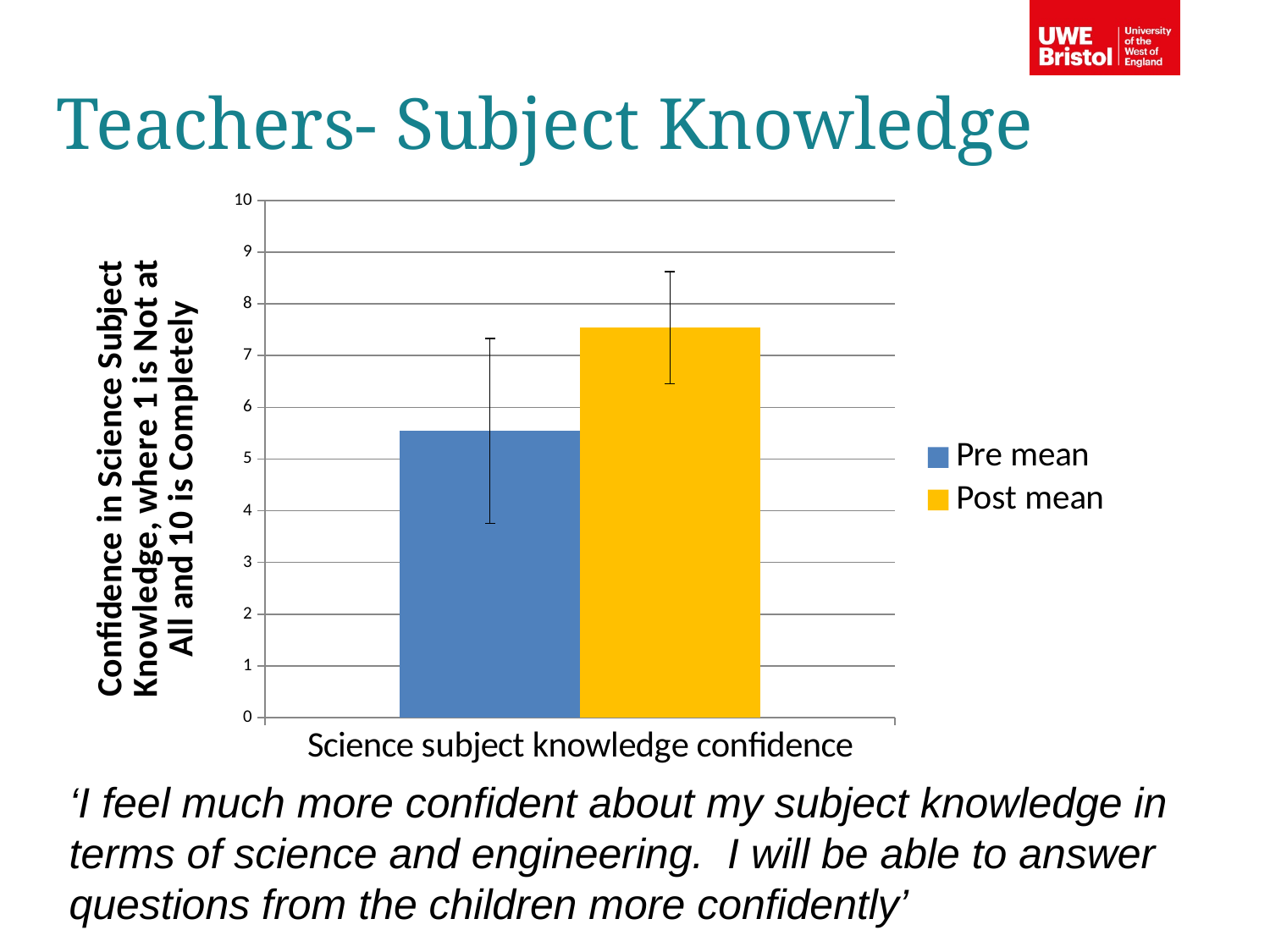
What is the category label shown on the x axis? Science subject knowledge confidence Is the value for Pre mean greater or less than 5? greater Is the value for Post mean greater or less than 7? greater Which series has the lowest bar? Pre mean Is the value for Pre mean greater or less than 6? less How many series does the legend list? 2 What kind of chart is shown on the slide? bar chart What colour is the Post mean bar? yellow Which series has the higher value: Pre mean or Post mean? Post mean Which series has the highest bar? Post mean How many categories are plotted on the x axis? 1